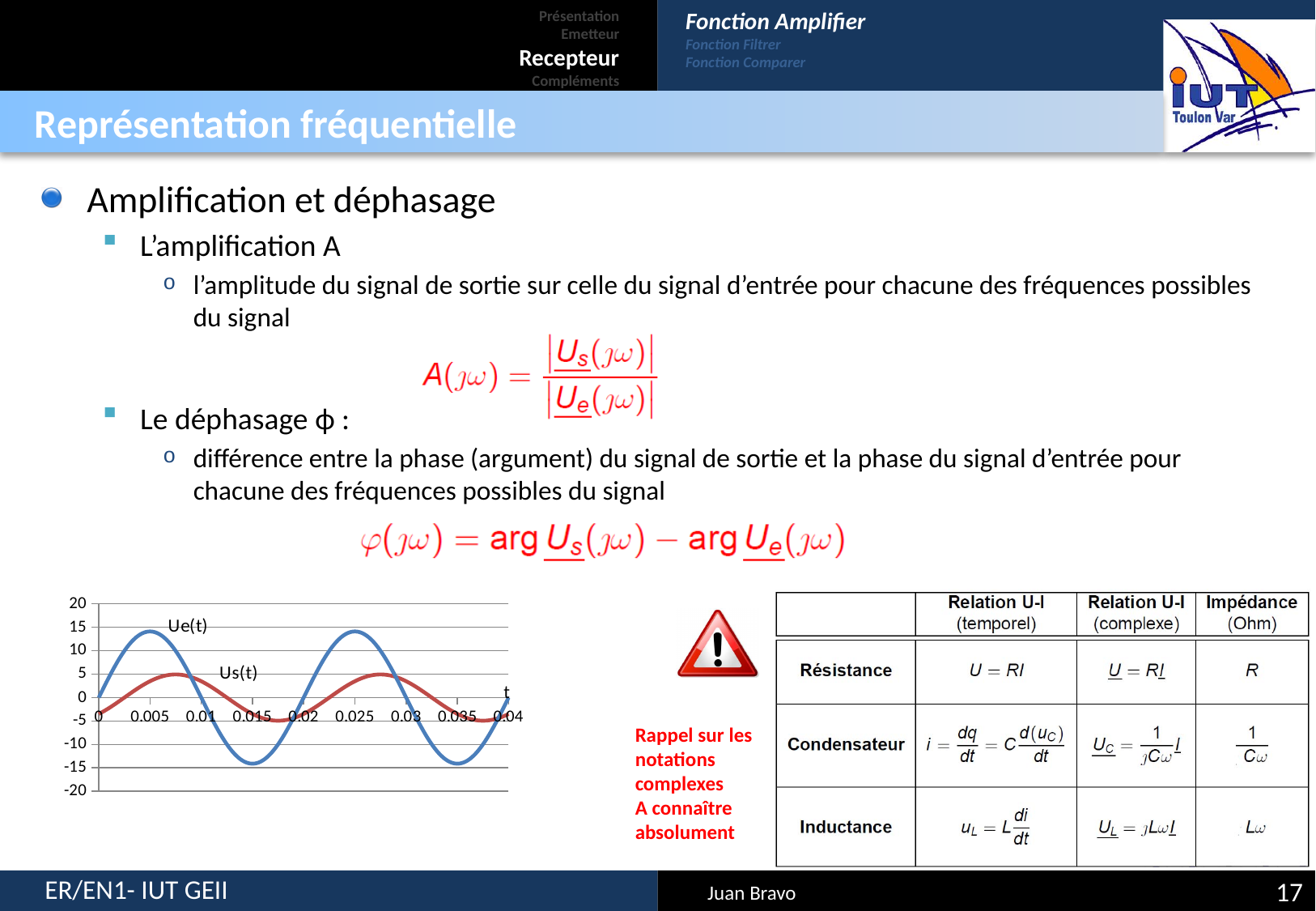
Which curve has the larger amplitude, Ue(t) or Us(t)? Ue(t) What colour is the Us(t) curve on the chart? red How many signals are plotted on the chart at the bottom left? 2 Is the peak value of Us(t) greater or less than 10? less What is the highest value shown on the vertical axis of the chart? 20 What is the largest value shown on the horizontal axis of the chart? 0.04 Is the peak value of Ue(t) greater or less than 10? greater How many full periods of Ue(t) are visible on the chart? 2 How many tick labels are shown on the horizontal axis of the chart? 9 What are the names of the two curves plotted on the chart? Ue(t) and Us(t) Is the minimum value of Ue(t) greater or less than -10? less What kind of chart is shown at the bottom left of the slide? line chart